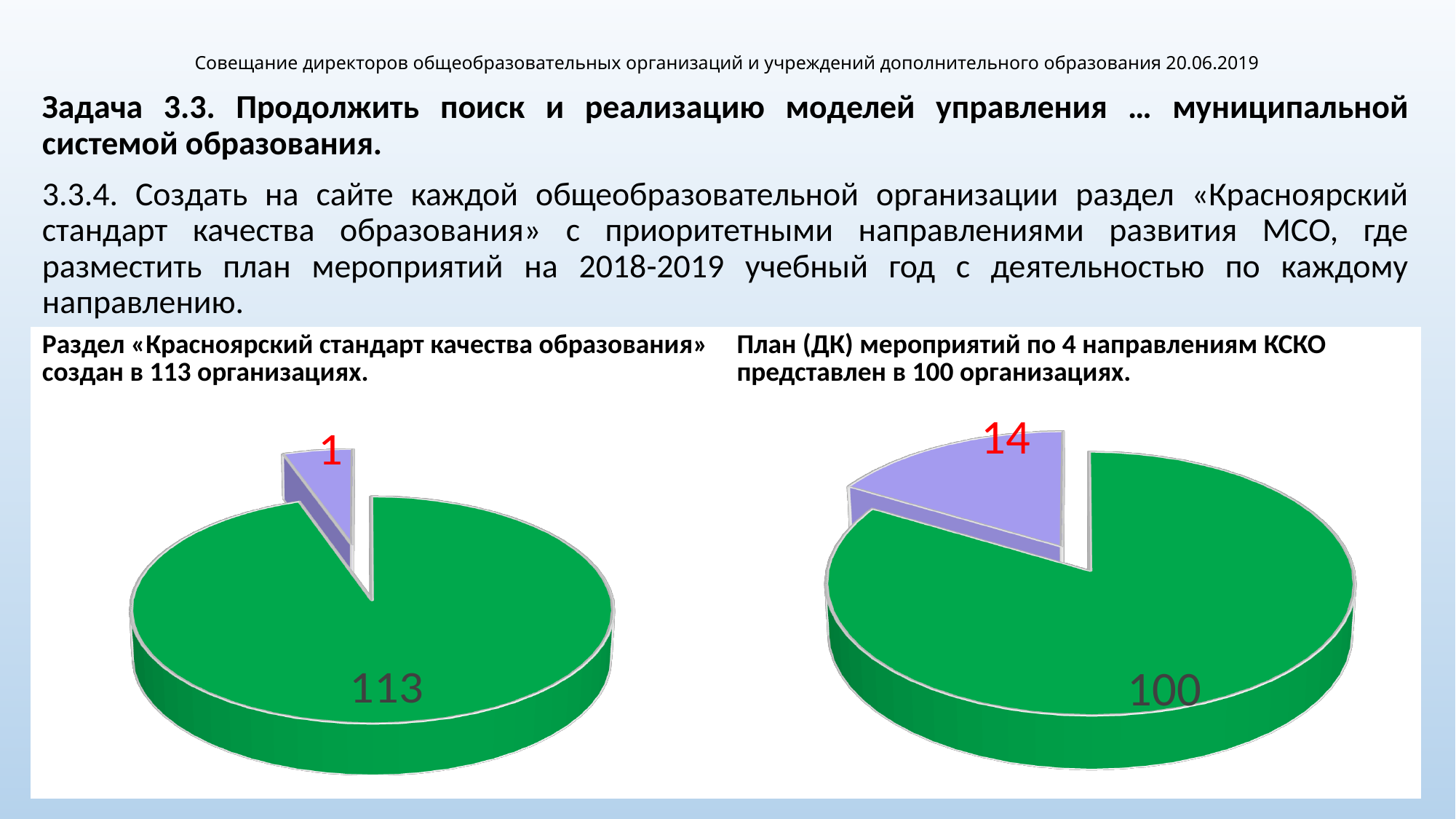
In the left chart, what colour is the slice labelled 1? Purple How many slices does the left pie chart have? 2 In the left chart, what value is shown on the large green slice? 113 In the right chart, what value is shown on the purple slice? 14 In the right chart, what is the difference between the green slice value and the purple slice value? 86 What kind of chart is the left chart on the slide? Pie chart In the right chart, which slice is larger, the green one or the purple one? The green one How many slices does the right pie chart have? 2 In the right chart, what value is shown on the green slice? 100 In the left chart, what is the total of the two slice values? 114 What kind of chart is the right chart on the slide? Pie chart In the left chart, what value is shown on the small purple slice? 1